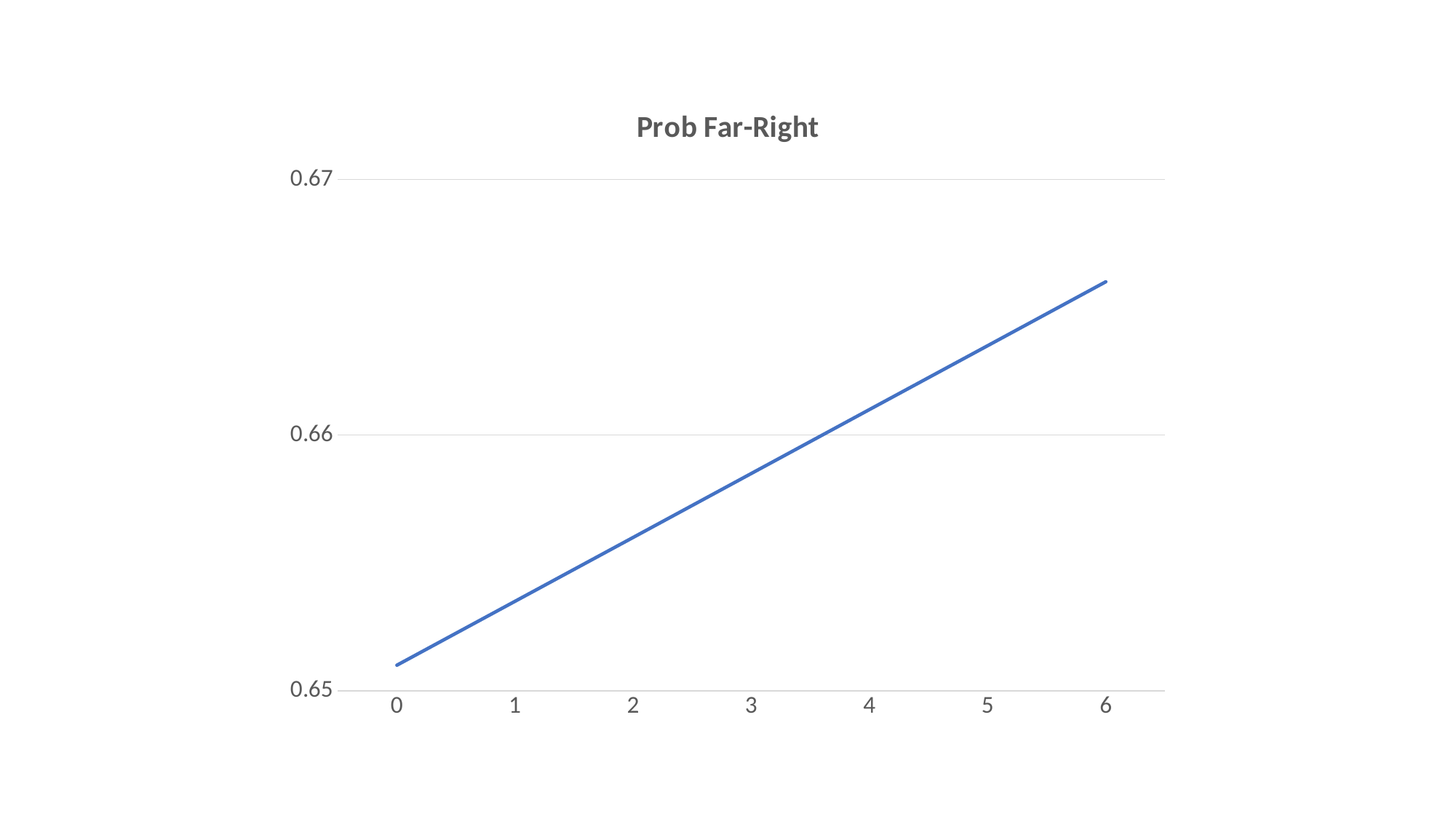
Is the value at x = 0 greater or less than 0.66? less What kind of chart is shown on the slide? line chart Is the value at x = 2 greater or less than 0.66? less What is the highest value labelled on the vertical axis? 0.67 What is the title of the chart? Prob Far-Right Which is larger, the value at x = 6 or the value at x = 0? x = 6 Do the values rise or fall as x increases from 0 to 6? rise At which x value is the line highest? 6 Is the value at x = 6 greater or less than 0.66? greater At which x value is the line lowest? 0